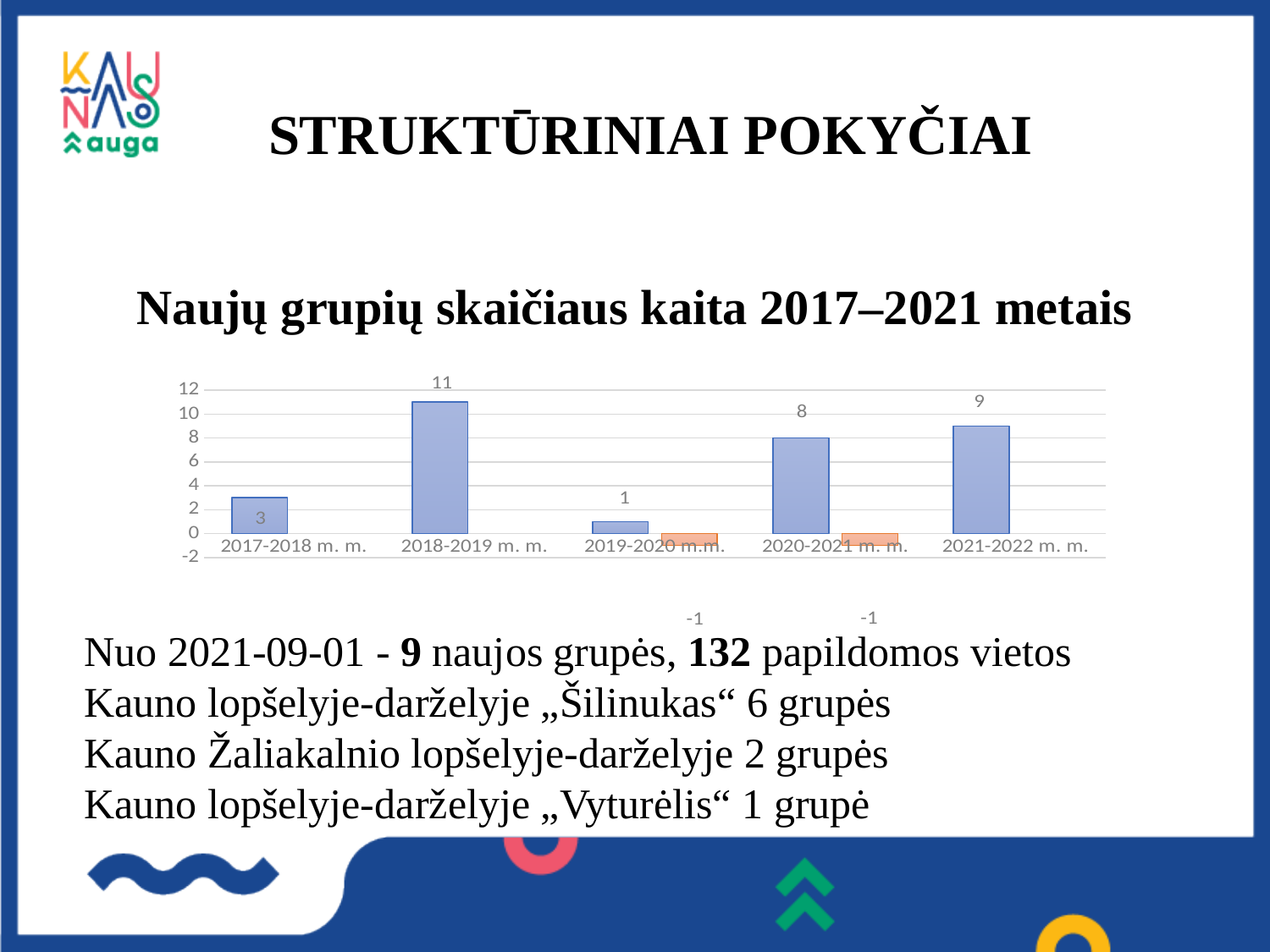
What is the value of the blue bar for 2017-2018 m. m.? 3 What is the difference between the blue bar values for 2018-2019 m. m. and 2020-2021 m. m.? 3 Which school year has the highest blue bar? 2018-2019 m. m. What is the value of the blue bar for 2020-2021 m. m.? 8 What type of chart is shown on the slide? bar chart What is the title of the chart? Naujų grupių skaičiaus kaita 2017–2021 metais What is the value of the blue bar for 2018-2019 m. m.? 11 How many school-year categories are shown on the x axis? 5 Which is larger, the blue bar for 2021-2022 m. m. or for 2020-2021 m. m.? 2021-2022 m. m. Which school year has the lowest blue bar? 2019-2020 m. m. What is the value of the blue bar for 2021-2022 m. m.? 9 What is the value of the orange bar for 2019-2020 m. m.? -1